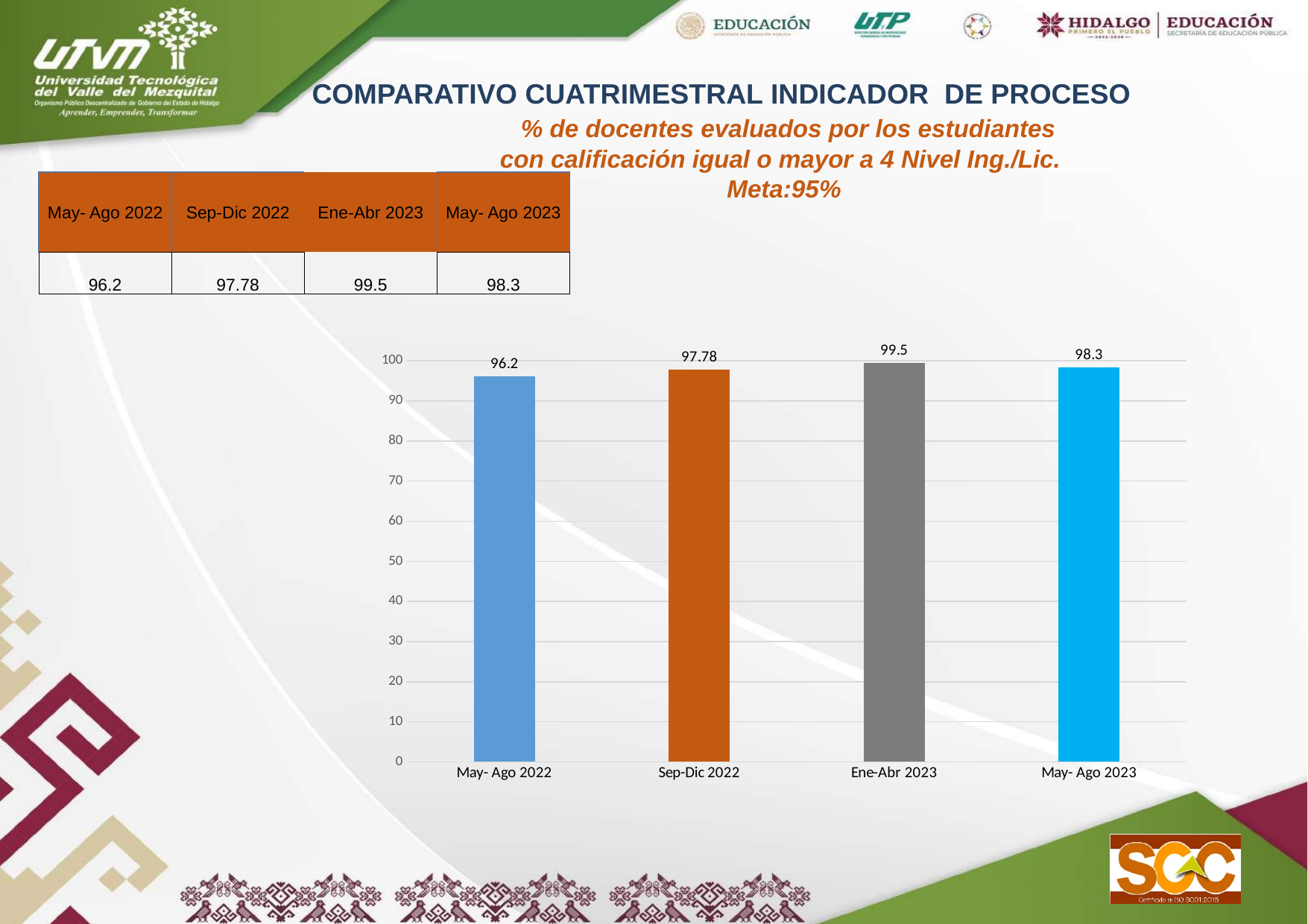
Which is larger, the value for Sep-Dic 2022 or the value for May- Ago 2023? May- Ago 2023 What kind of chart is shown on the slide? bar chart What is the difference between the values for Ene-Abr 2023 and May- Ago 2022? 3.3 What is the value for May- Ago 2022? 96.2 Which period has the highest value? Ene-Abr 2023 What is the value for Ene-Abr 2023? 99.5 What colour is the bar for Ene-Abr 2023? grey What is the difference between the values for May- Ago 2023 and Sep-Dic 2022? 0.52 Which period has the lowest value? May- Ago 2022 What is the value for Sep-Dic 2022? 97.78 How many periods are shown on the x axis of the chart? 4 What is the value for May- Ago 2023? 98.3